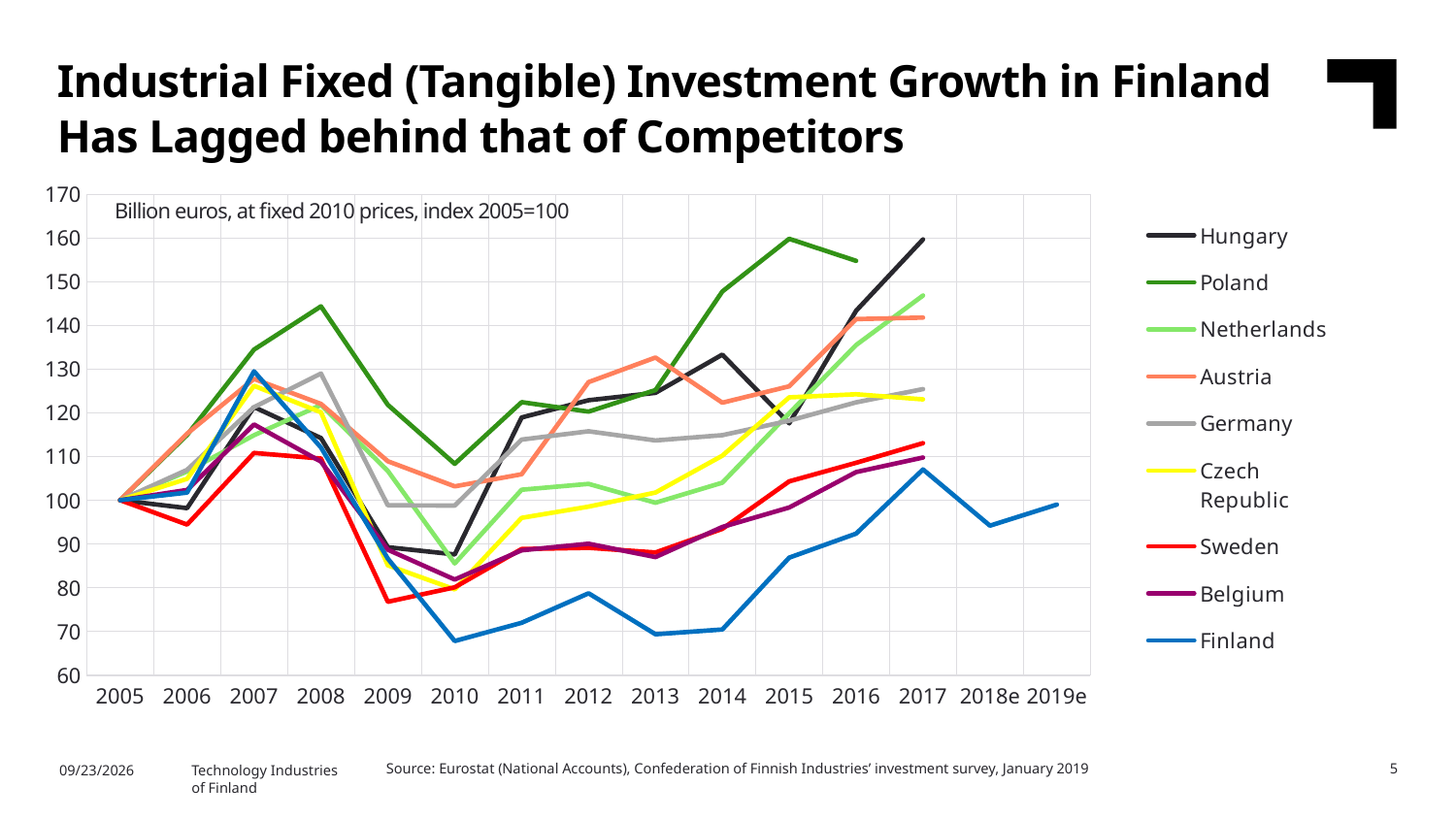
What kind of chart is shown on the slide? line chart What is the index value for Finland in 2005? 100 How many years are shown along the x axis? 15 How many series does the legend list? 9 Is the value for Poland in 2015 greater or less than 150? greater What unit description is printed inside the chart area? Billion euros, at fixed 2010 prices, index 2005=100 Does the value for Finland rise or fall from 2017 to 2018e? fall Is the value for Sweden in 2009 greater or less than 80? less Which country has the lowest value in 2013? Finland Is the value for Finland in 2010 greater or less than 80? less Which country has the highest value in 2015? Poland In 2017, which is larger, the value for Hungary or the value for Finland? Hungary